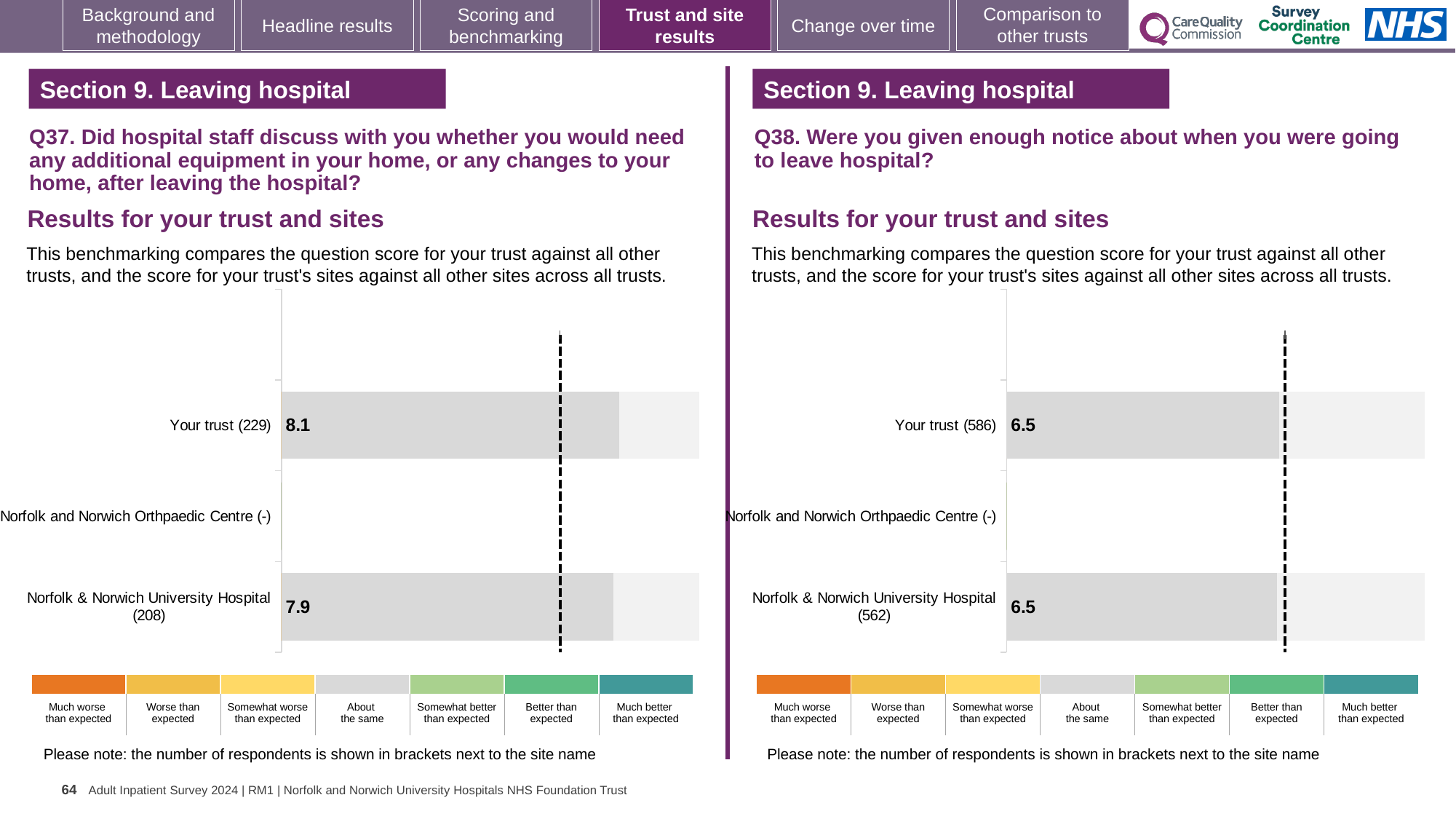
In the Q37 chart on the left, how many respondents are shown in brackets for Norfolk & Norwich University Hospital? 208 In the Q37 chart on the left, which labelled row has the highest score? Your trust (229) In the Q37 chart on the left, which has the higher score: Your trust (229) or Norfolk & Norwich University Hospital (208)? Your trust (229) In the Q38 chart on the right, is the score for Your trust (586) greater or less than 8? less In the Q38 chart on the right, what is the score for Your trust (586)? 6.5 What kind of chart is used in the Q37 chart on the left? Bar chart In the Q37 chart on the left, what is the score for Norfolk & Norwich University Hospital (208)? 7.9 In the Q38 chart on the right, what is the score for Norfolk & Norwich University Hospital (562)? 6.5 In the Q38 chart on the right, how many respondents are shown in brackets for Your trust? 586 In the Q37 chart on the left, what is the difference between the score for Your trust (229) and the score for Norfolk & Norwich University Hospital (208)? 0.2 In the Q37 chart on the left, what is the score for Your trust (229)? 8.1 How many rows (categories) are listed on the y axis of the Q38 chart on the right? 3